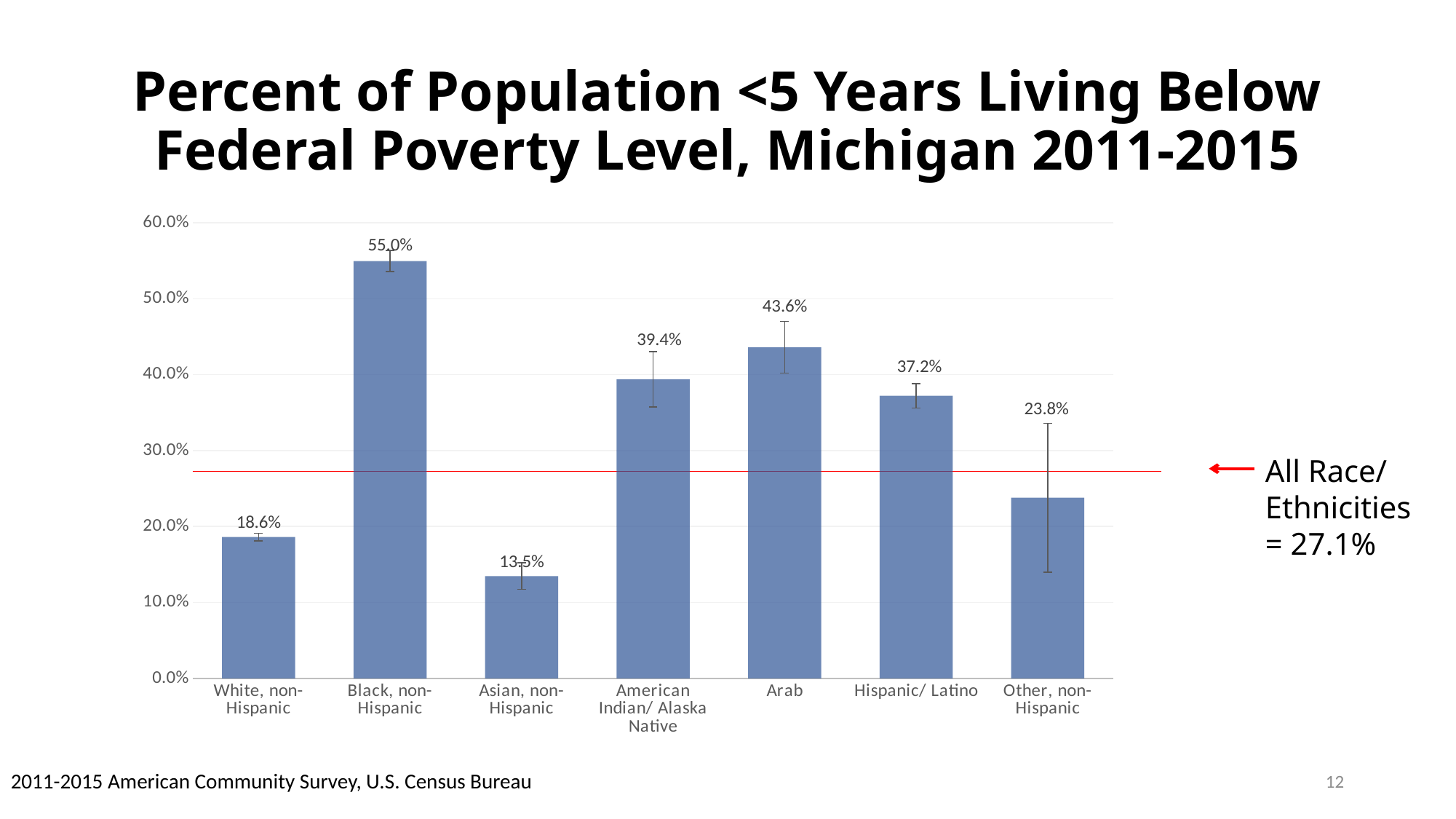
How many categories are shown on the x axis? 7 What value does the horizontal reference line labelled 'All Race/ Ethnicities' represent? 27.1% Which category has the highest value? Black, non-Hispanic What is the value for Black, non-Hispanic? 55.0% What is the value for Asian, non-Hispanic? 13.5% What is the value for Arab? 43.6% Which category has the lowest value? Asian, non-Hispanic What is the difference between the values for Black, non-Hispanic and White, non-Hispanic? 36.4% Which is larger, the value for American Indian/ Alaska Native or the value for Hispanic/ Latino? American Indian/ Alaska Native What kind of chart is shown on the slide? bar chart What is the value for Other, non-Hispanic? 23.8% Is the value for Hispanic/ Latino greater or less than 30.0%? greater